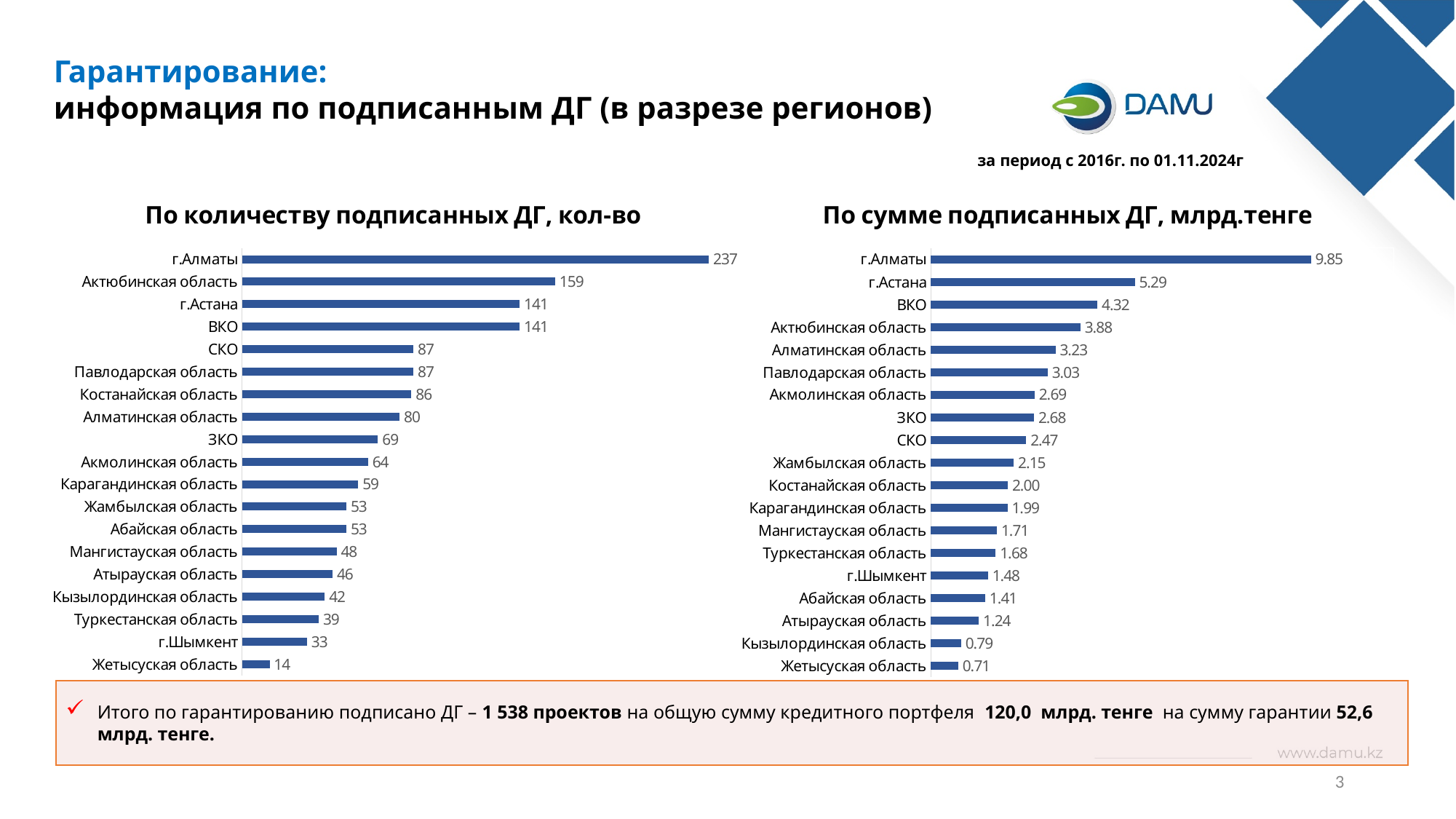
In the chart 'По сумме подписанных ДГ, млрд.тенге', which region has the highest value? г.Алматы What type of chart is 'По количеству подписанных ДГ, кол-во'? Bar chart In the chart 'По сумме подписанных ДГ, млрд.тенге', what is the value for Кызылординская область? 0.79 In the chart 'По сумме подписанных ДГ, млрд.тенге', what is the difference between г.Алматы and г.Астана? 4.56 In the chart 'По количеству подписанных ДГ, кол-во', what is the difference between г.Алматы and г.Астана? 96 In the chart 'По количеству подписанных ДГ, кол-во', what is the value for Актюбинская область? 159 In the chart 'По количеству подписанных ДГ, кол-во', which region has the lowest value? Жетысуская область In the chart 'По количеству подписанных ДГ, кол-во', which region has the highest value? г.Алматы In the chart 'По сумме подписанных ДГ, млрд.тенге', which is larger: г.Астана or Актюбинская область? г.Астана In the chart 'По количеству подписанных ДГ, кол-во', how many regions are shown? 19 What is the title of the chart on the right side of the slide? По сумме подписанных ДГ, млрд.тенге In the chart 'По сумме подписанных ДГ, млрд.тенге', what is the value for ВКО? 4.32